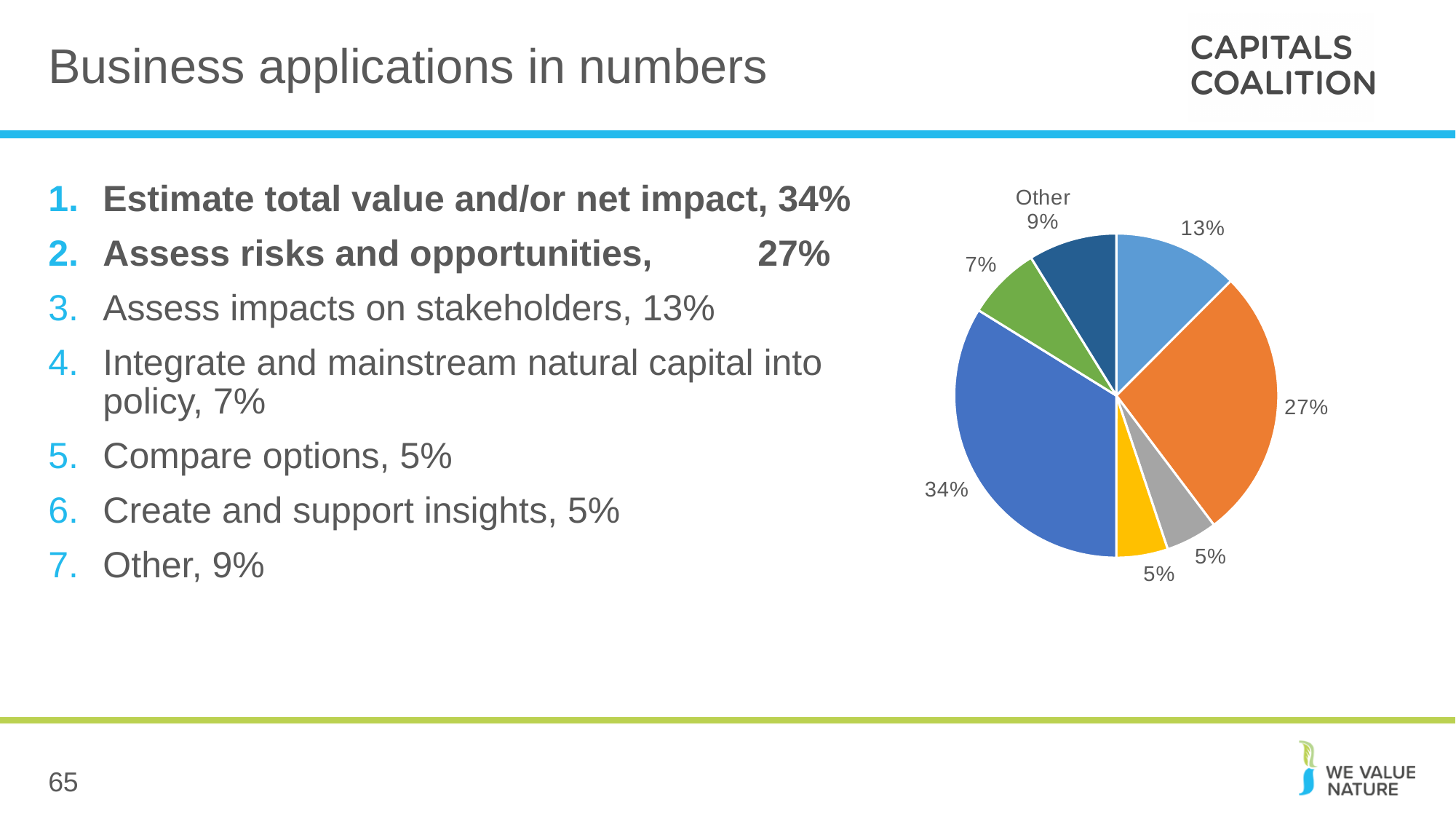
What share of the pie does the 'Other' slice represent? 9% What kind of chart is shown on the slide? pie chart How many slices in the pie chart are labelled 5%? 2 What is the percentage shown on the largest slice of the pie chart? 34% Which slice of the pie chart is labelled with a category name rather than only a percentage? Other How many slices does the pie chart have? 7 Which is larger in the pie chart, the 13% slice or the 'Other' slice at 9%? the 13% slice What colour is the largest (34%) slice of the pie chart? blue What is the difference between the largest slice (34%) and the 27% slice? 7% What is the percentage shown on the smallest slices of the pie chart? 5% What is the combined share of the two 5% slices in the pie chart? 10% What is the difference between the 'Other' slice (9%) and the 7% slice? 2%